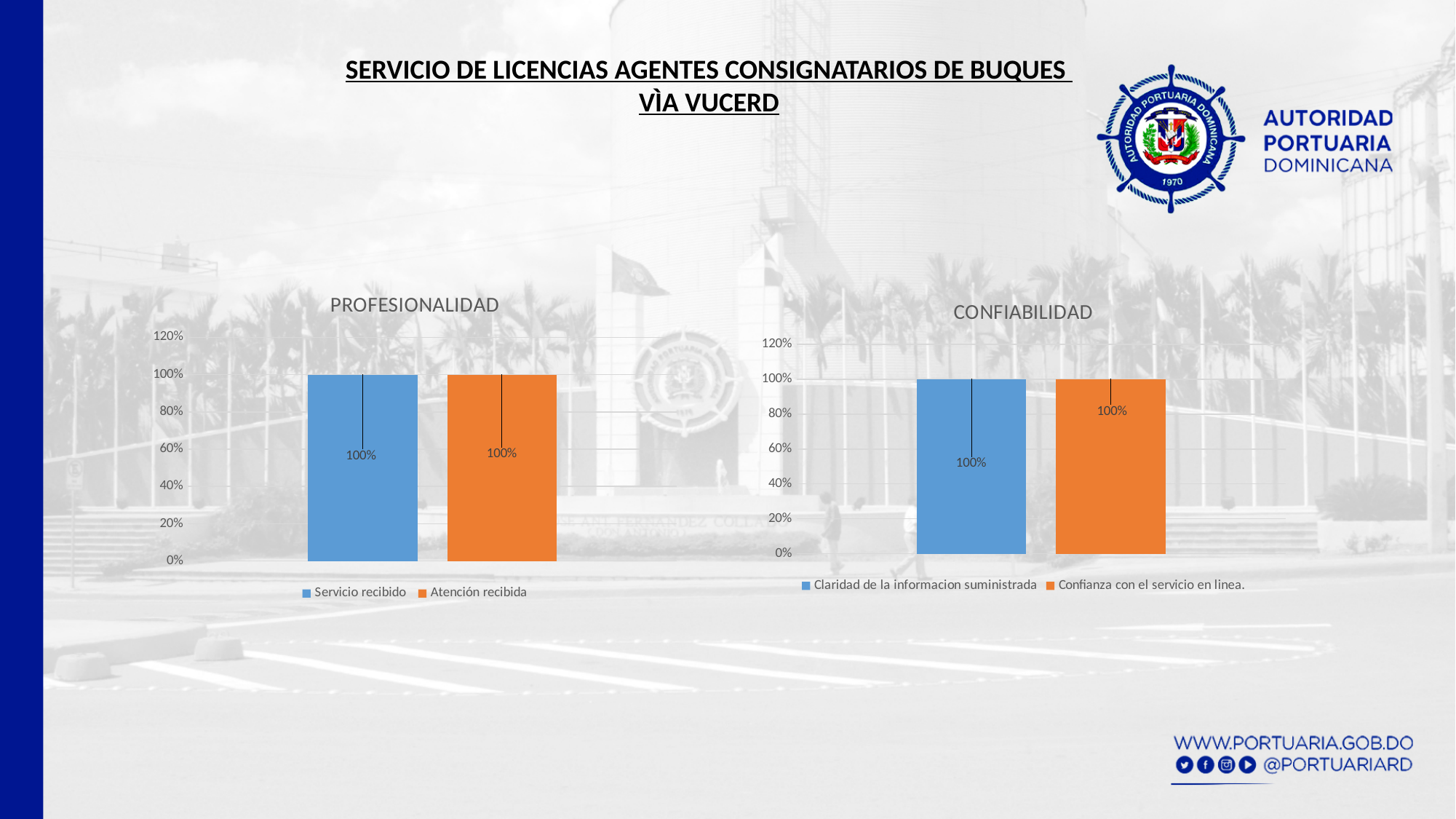
In the PROFESIONALIDAD chart, what is the value for Atención recibida? 100% In the CONFIABILIDAD chart, what is the value for Confianza con el servicio en linea? 100% In the PROFESIONALIDAD chart, what colour is the bar for Atención recibida? Orange In the PROFESIONALIDAD chart, what is the value for Servicio recibido? 100% How many series does the legend of the PROFESIONALIDAD chart list? 2 What is the title of the chart on the right side of the slide? CONFIABILIDAD What kind of chart is the PROFESIONALIDAD chart? Bar chart In the PROFESIONALIDAD chart, what is the difference between Servicio recibido and Atención recibida? 0% In the CONFIABILIDAD chart, is the value for Claridad de la informacion suministrada greater or less than 80%? greater How many series does the legend of the CONFIABILIDAD chart list? 2 In the CONFIABILIDAD chart, what is the value for Claridad de la informacion suministrada? 100% How many bars are plotted in the CONFIABILIDAD chart? 2